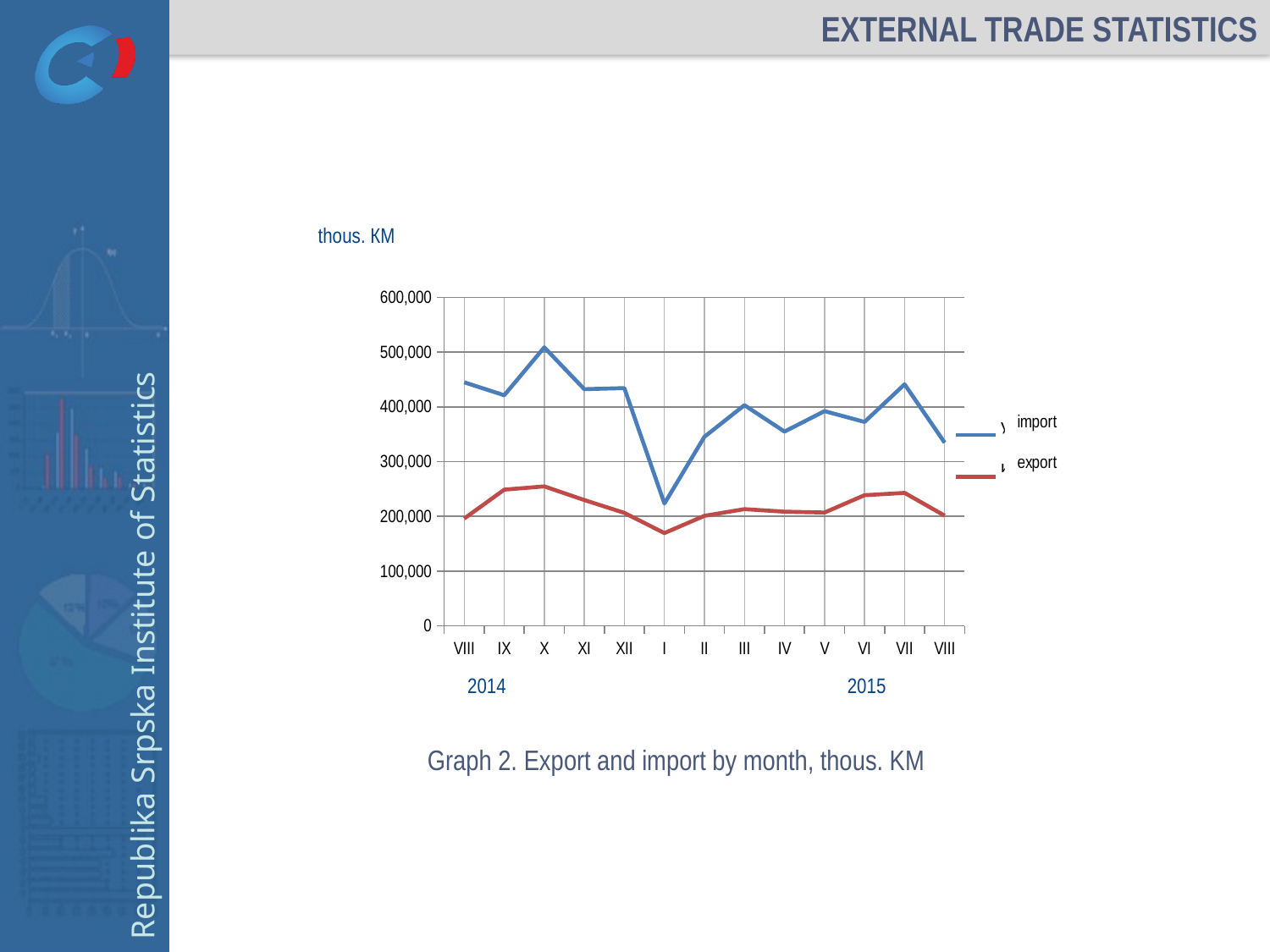
In which month is the import value lowest? I 2015 Is the export value for I 2015 greater or less than 200,000? less What kind of chart is shown on the slide? line chart Is the import value for X 2014 greater or less than 400,000? greater In which month is the export value lowest? I 2015 How many months are plotted along the x axis? 13 Which is larger in VIII 2015, import or export? import How many series does the legend list? 2 Is the import value for I 2015 greater or less than 300,000? less Does the import value rise or fall from XII 2014 to I 2015? fall Which two series are listed in the legend? import and export In which month is the import value highest? X 2014